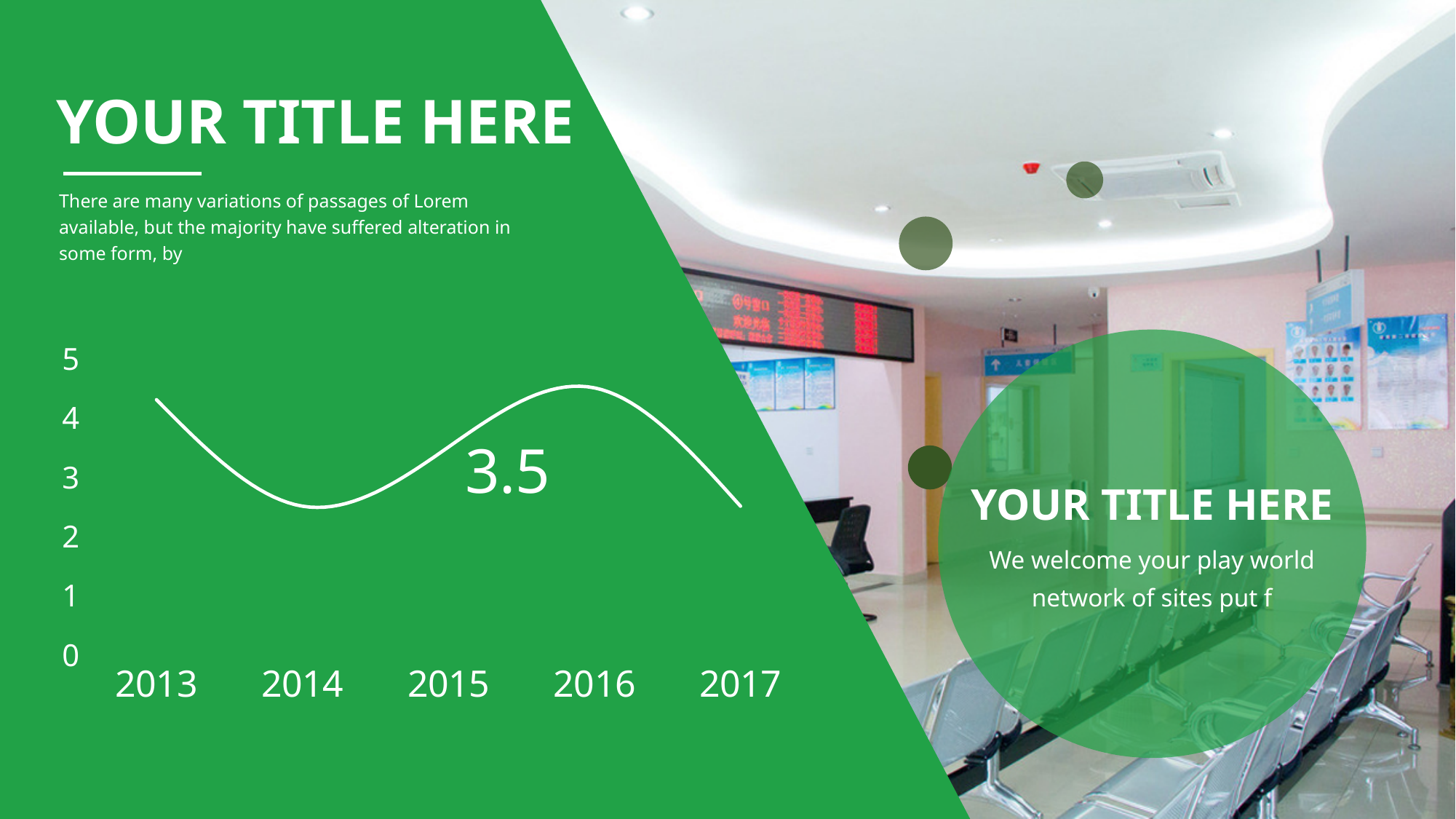
Which is larger, the value for 2016 or the value for 2017? 2016 What is the highest value shown on the y axis of the chart? 5 Is the value for 2014 greater or less than 3? less Is the value for 2013 greater or less than 3? greater Is the value for 2017 greater or less than 3? less How many years are shown on the x axis of the chart? 5 Does the line rise or fall from 2016 to 2017? fall What is the first year shown on the x axis of the chart? 2013 What data label is printed on the line in the chart? 3.5 Which is larger, the value for 2013 or the value for 2014? 2013 What kind of chart is shown on the slide? line chart